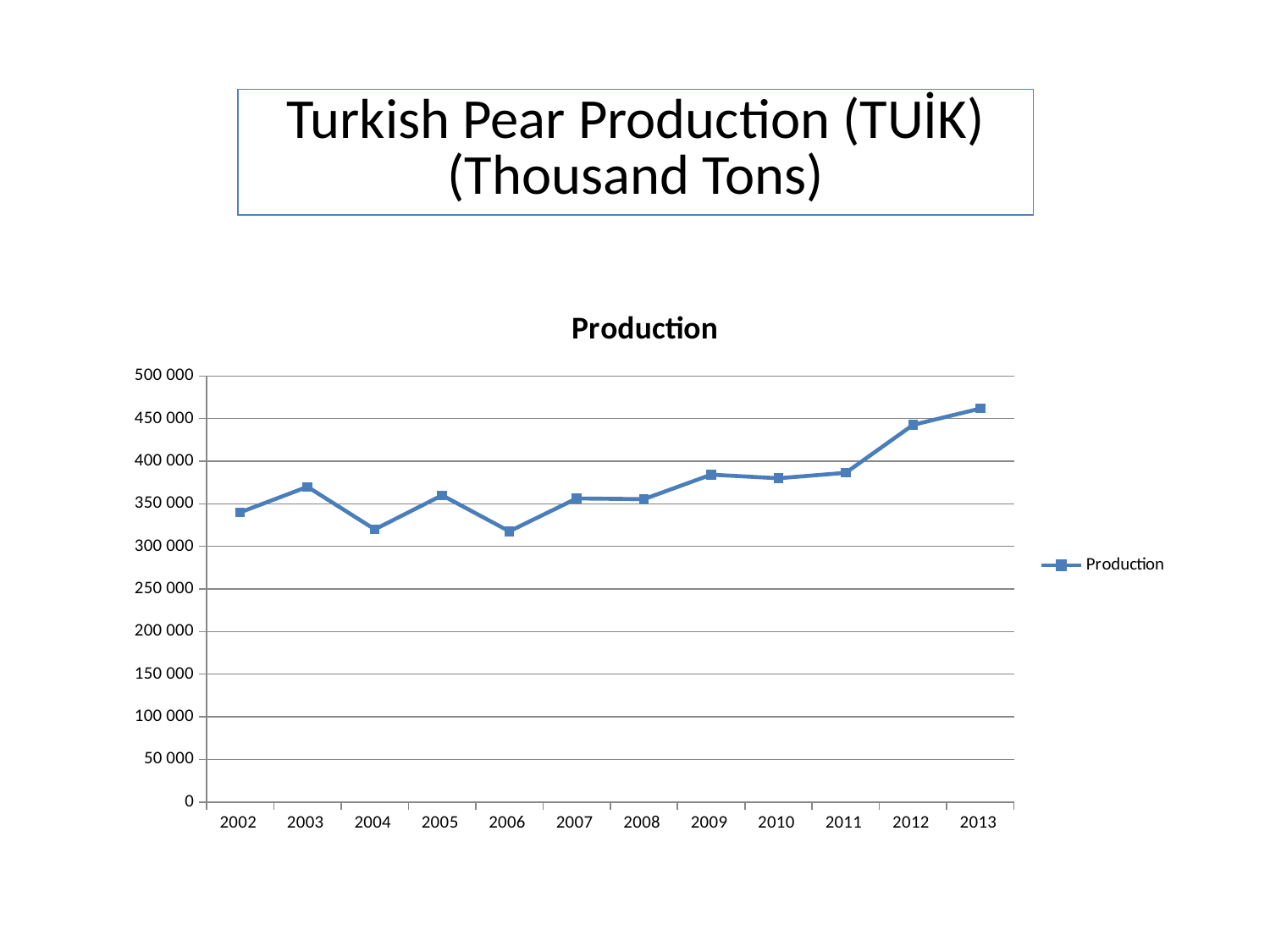
Which year has the highest production value in the chart? 2013 How many series does the legend of the Production chart list? 1 Which year has the larger production value, 2003 or 2012? 2012 What kind of chart is shown on the slide? line chart Which year has the larger production value, 2004 or 2005? 2005 Is the production value for 2013 greater or less than 450 000? greater Is the production value for 2006 greater or less than 300 000? greater Is the production value for 2012 greater or less than 450 000? less How many years are plotted on the x axis of the Production chart? 12 Does production rise or fall from 2011 to 2013? rise